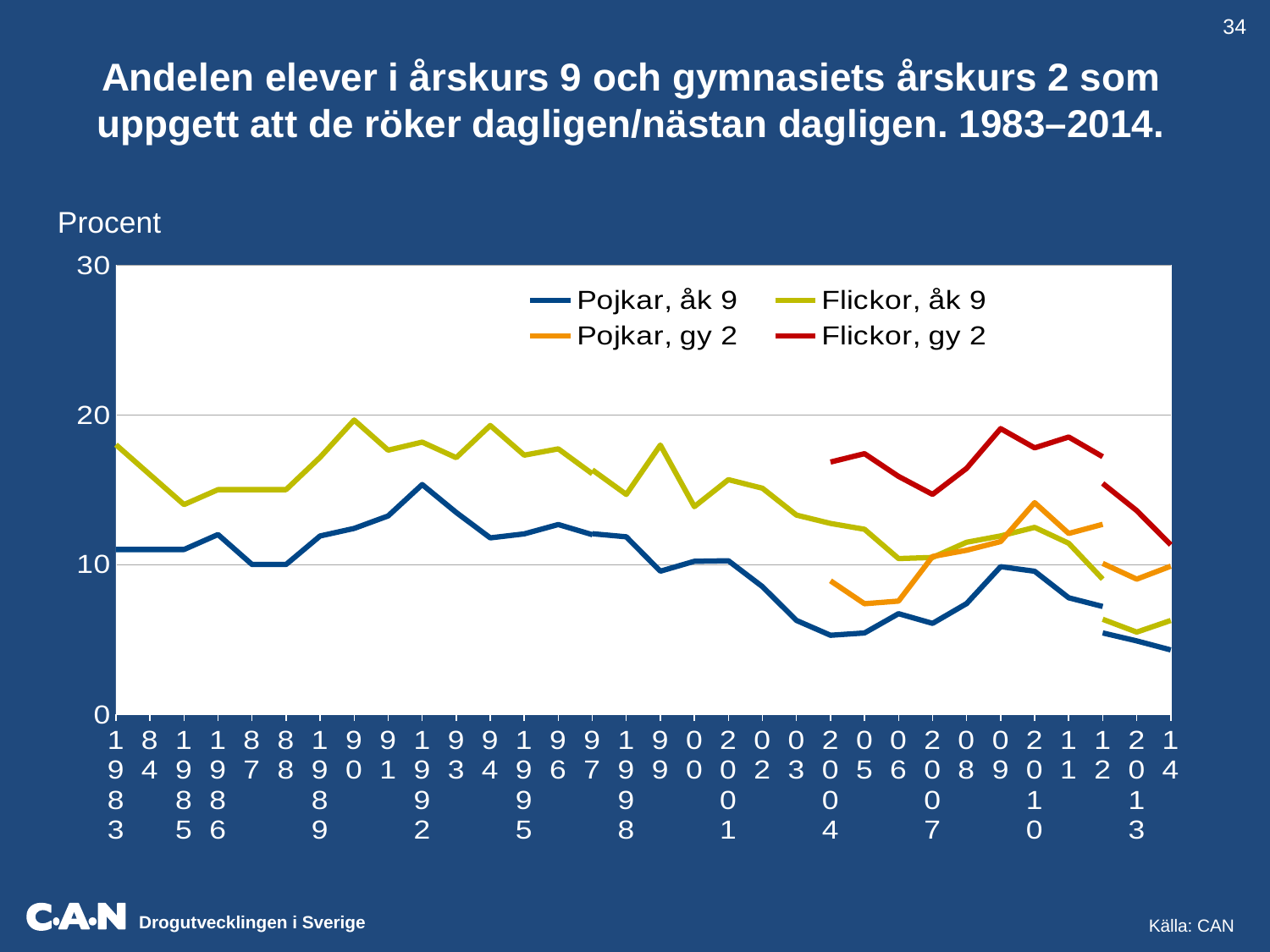
In 1983, which is higher: Flickor, åk 9 or Pojkar, åk 9? Flickor, åk 9 Is the value for Pojkar, åk 9 in 2014 greater or less than 10? less Is the value for Pojkar, åk 9 in 1992 greater or less than 10? greater What kind of chart is shown on the slide? line chart How many series does the legend list? 4 Which series has the highest value in 2010? Flickor, gy 2 Is the value for Flickor, åk 9 in 1983 greater or less than 10? greater In 2014, which is higher: Flickor, gy 2 or Pojkar, gy 2? Flickor, gy 2 Overall, does the Flickor, åk 9 line rise or fall from 1983 to 2014? fall What unit is shown on the vertical axis label? Procent Which series are listed in the legend? Pojkar, åk 9; Pojkar, gy 2; Flickor, åk 9; Flickor, gy 2